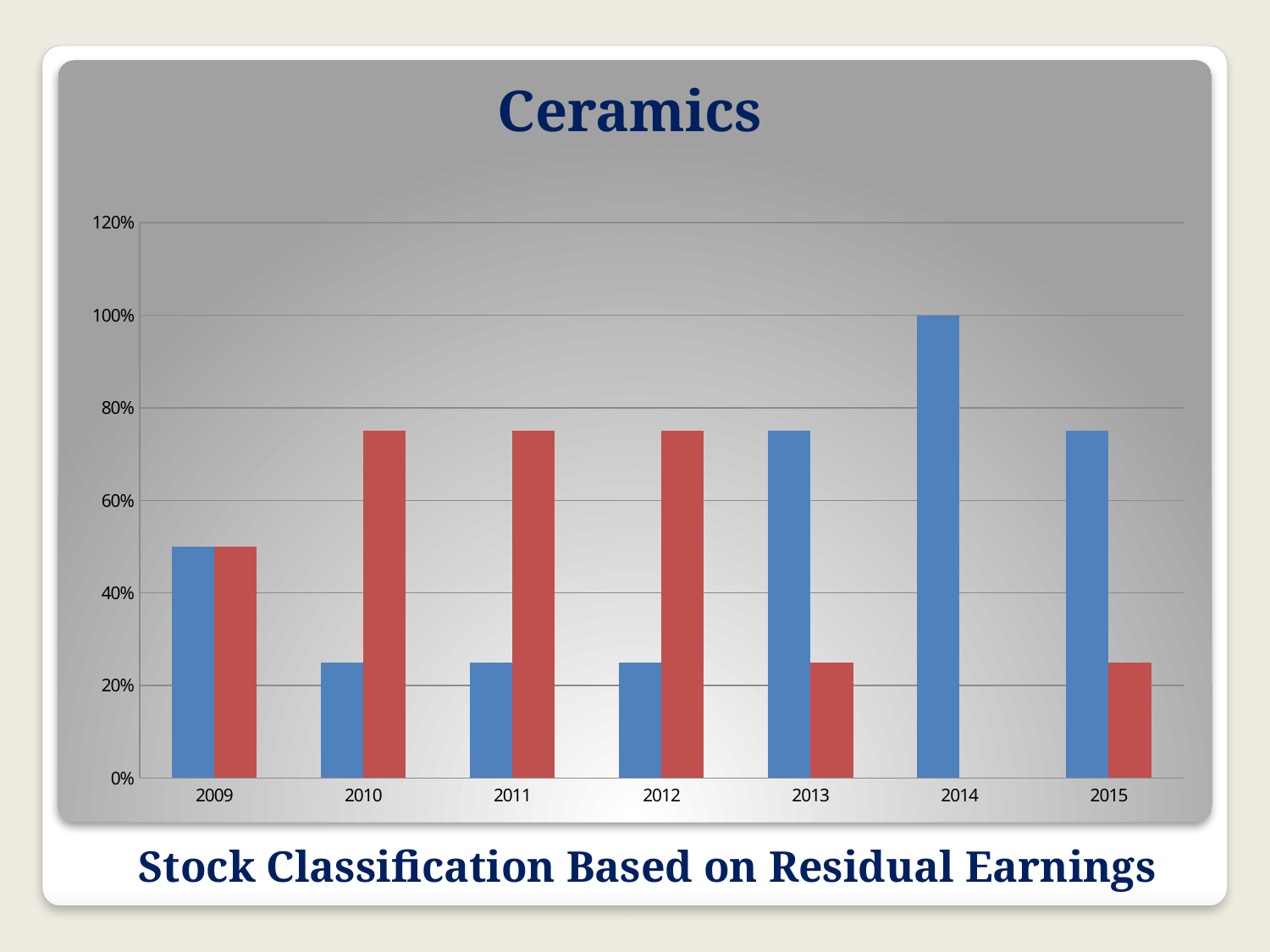
Is the value of the blue bar for 2010 greater or less than 40%? less Is the value of the blue bar for 2009 greater or less than 40%? greater In 2010, which bar is larger, the blue or the red? red Is the value of the red bar for 2015 greater or less than 40%? less In 2013, which bar is larger, the blue or the red? blue What kind of chart is shown on the slide? bar chart How many years are shown on the x axis? 7 What is the title of the chart? Ceramics In which year is the blue bar highest? 2014 What is the value of the blue bar for 2014? 100% Do the blue bars rise or fall from 2012 to 2014? rise